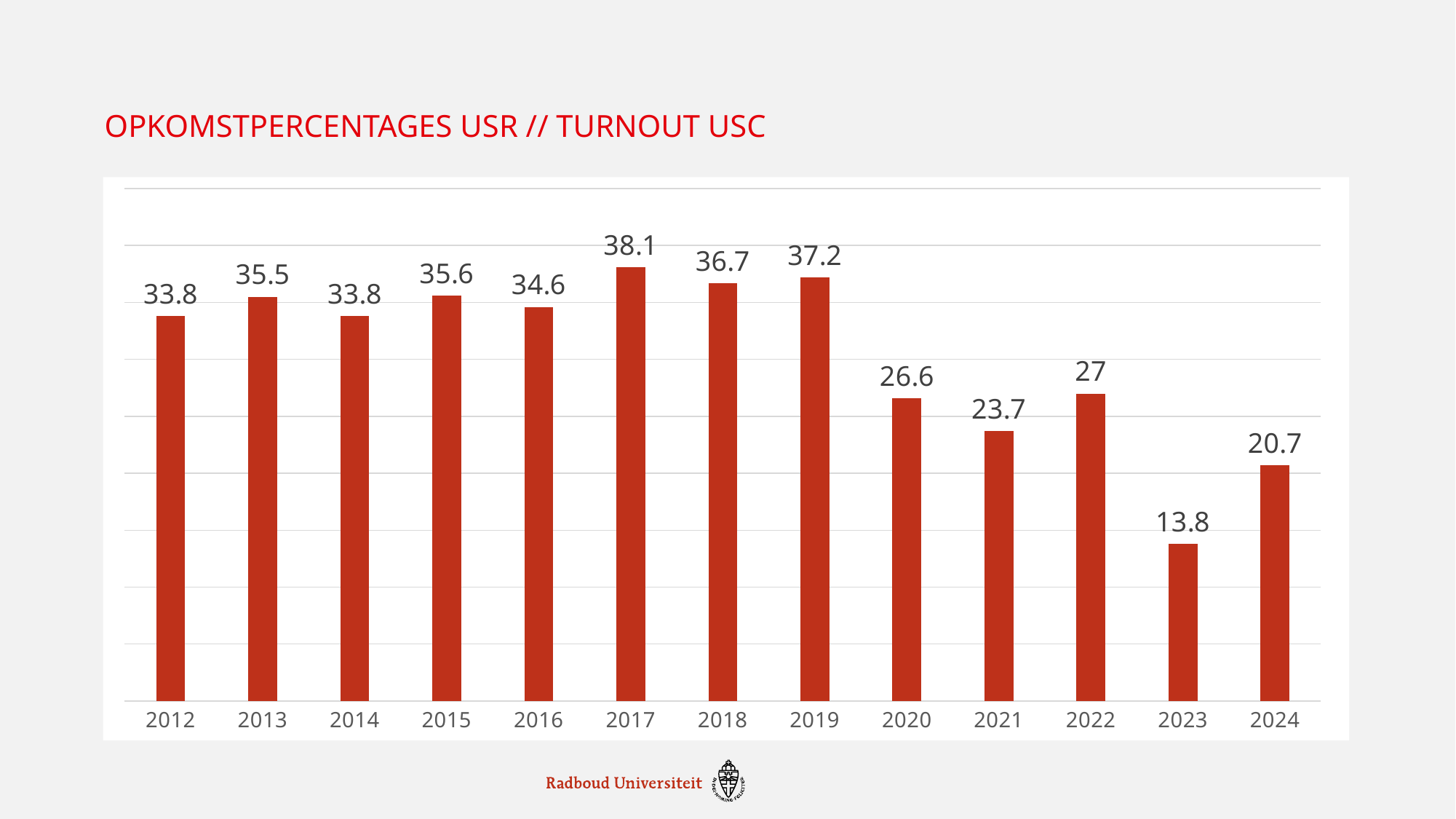
How many years are shown on the x axis? 13 What is the turnout value for 2023? 13.8 Which year has the lowest turnout? 2023 What is the turnout value for 2020? 26.6 What is the difference between the turnout in 2017 and the turnout in 2023? 24.3 Which year has a higher turnout, 2019 or 2018? 2019 What is the turnout value for 2024? 20.7 What kind of chart is shown on the slide? Bar chart What is the title of the slide? OPKOMSTPERCENTAGES USR // TURNOUT USC Which year has the highest turnout? 2017 What is the difference between the turnout in 2022 and the turnout in 2021? 3.3 What is the turnout value for 2017? 38.1